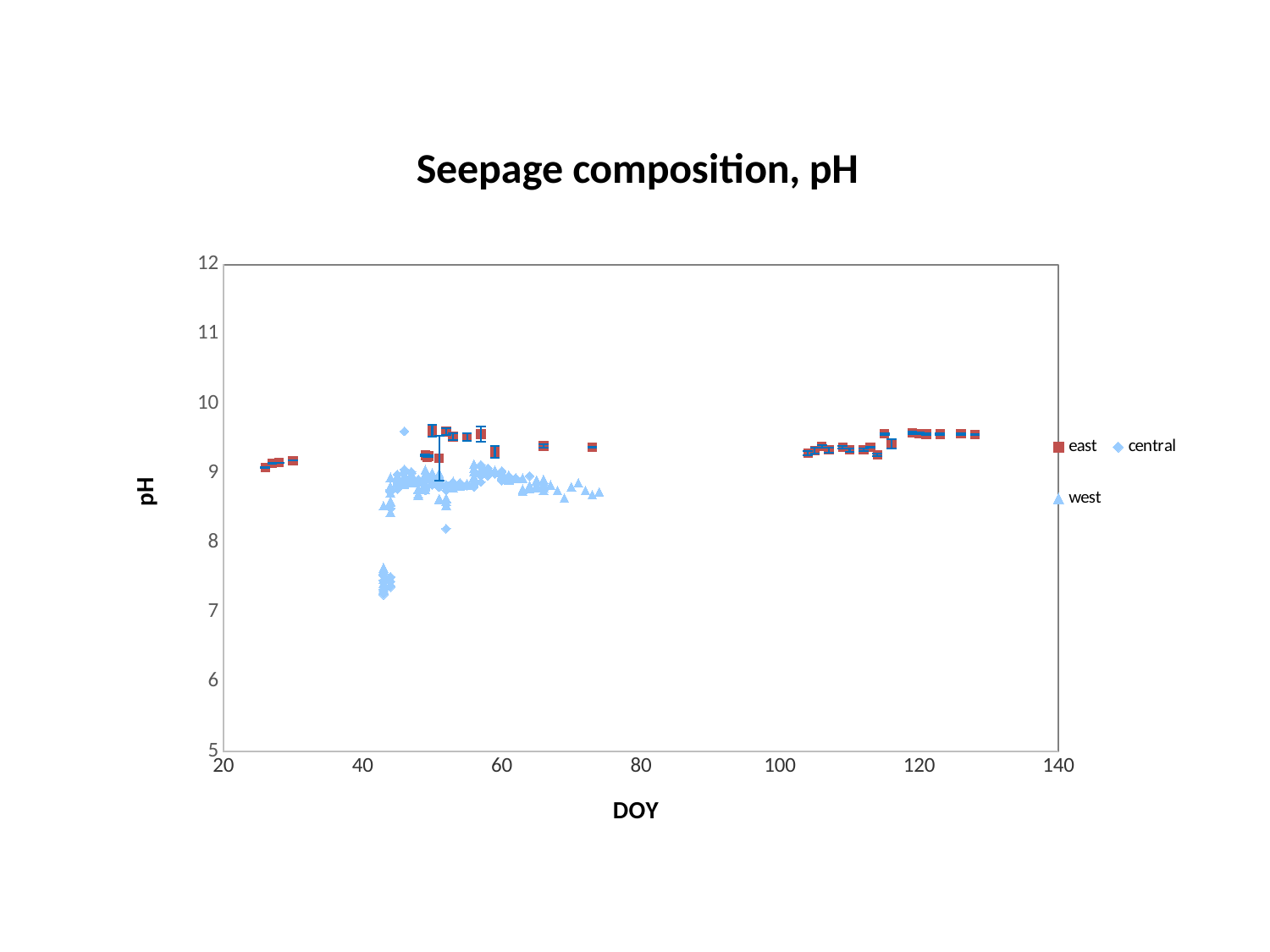
What is the label of the x axis? DOY Which series has the lowest pH values on the chart? central Are the central series values around DOY 43 greater or less than 8? less Are the west series values around DOY 70 greater or less than 9? less Are all plotted values greater or less than 11? less What is the title of the chart? Seepage composition, pH Which series is plotted with triangle markers? west How many series does the legend list? 3 What kind of chart is shown on the slide? scatter chart Around DOY 60, which series has the higher pH, east or west? east